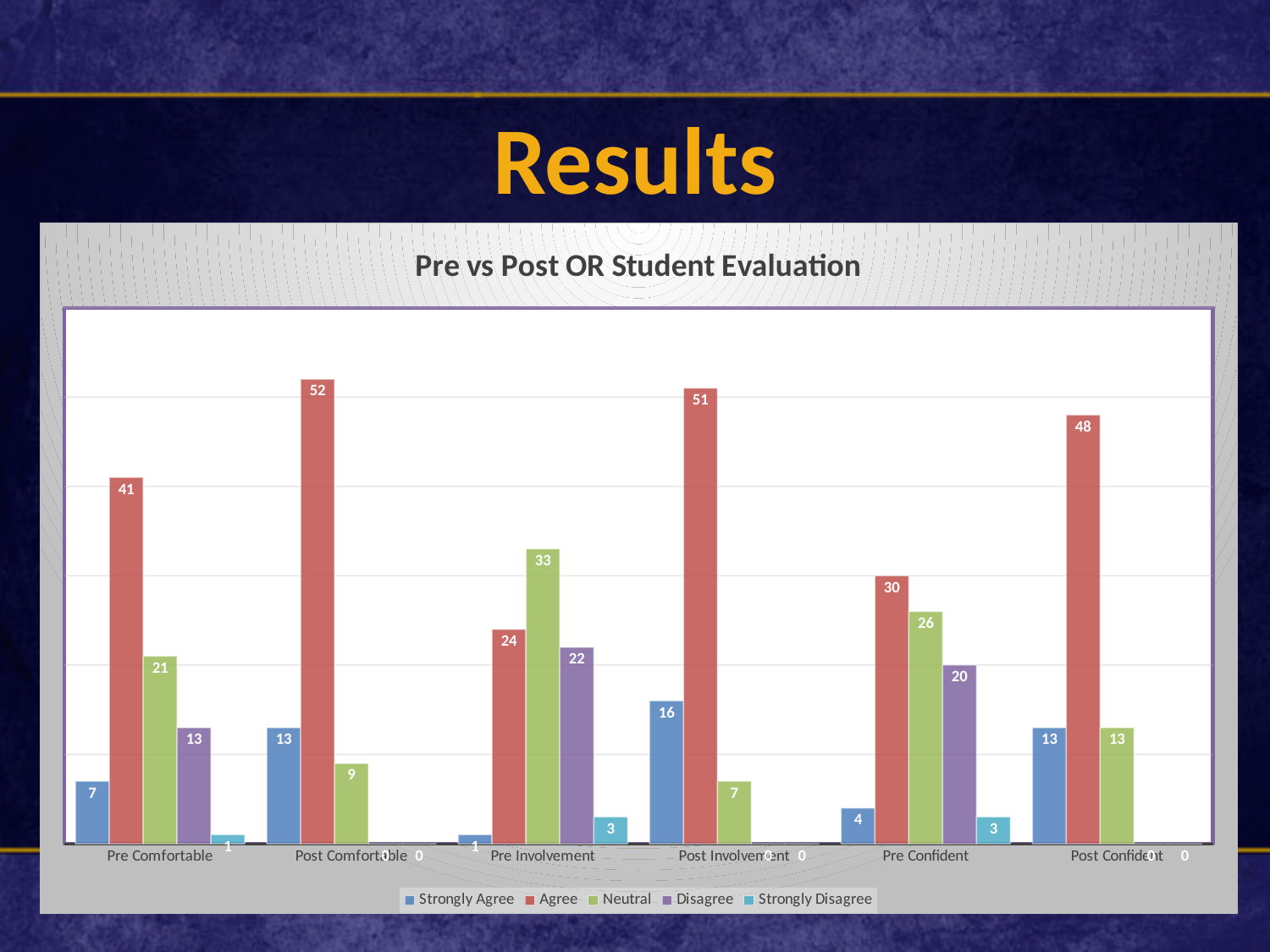
How many categories are shown on the x axis? 6 What is the Agree value for Post Comfortable? 52 What is the title of the chart? Pre vs Post OR Student Evaluation What is the difference between the Agree values for Post Confident and Pre Confident? 18 What kind of chart is shown on the slide? Bar chart Which is larger, the Neutral value for Pre Comfortable or the Neutral value for Pre Confident? Pre Confident What is the Disagree value for Pre Confident? 20 What is the Neutral value for Pre Involvement? 33 Which category has the highest Agree value? Post Comfortable How many series does the legend list? 5 Which category has the lowest Strongly Agree value? Pre Involvement What is the Strongly Agree value for Post Involvement? 16